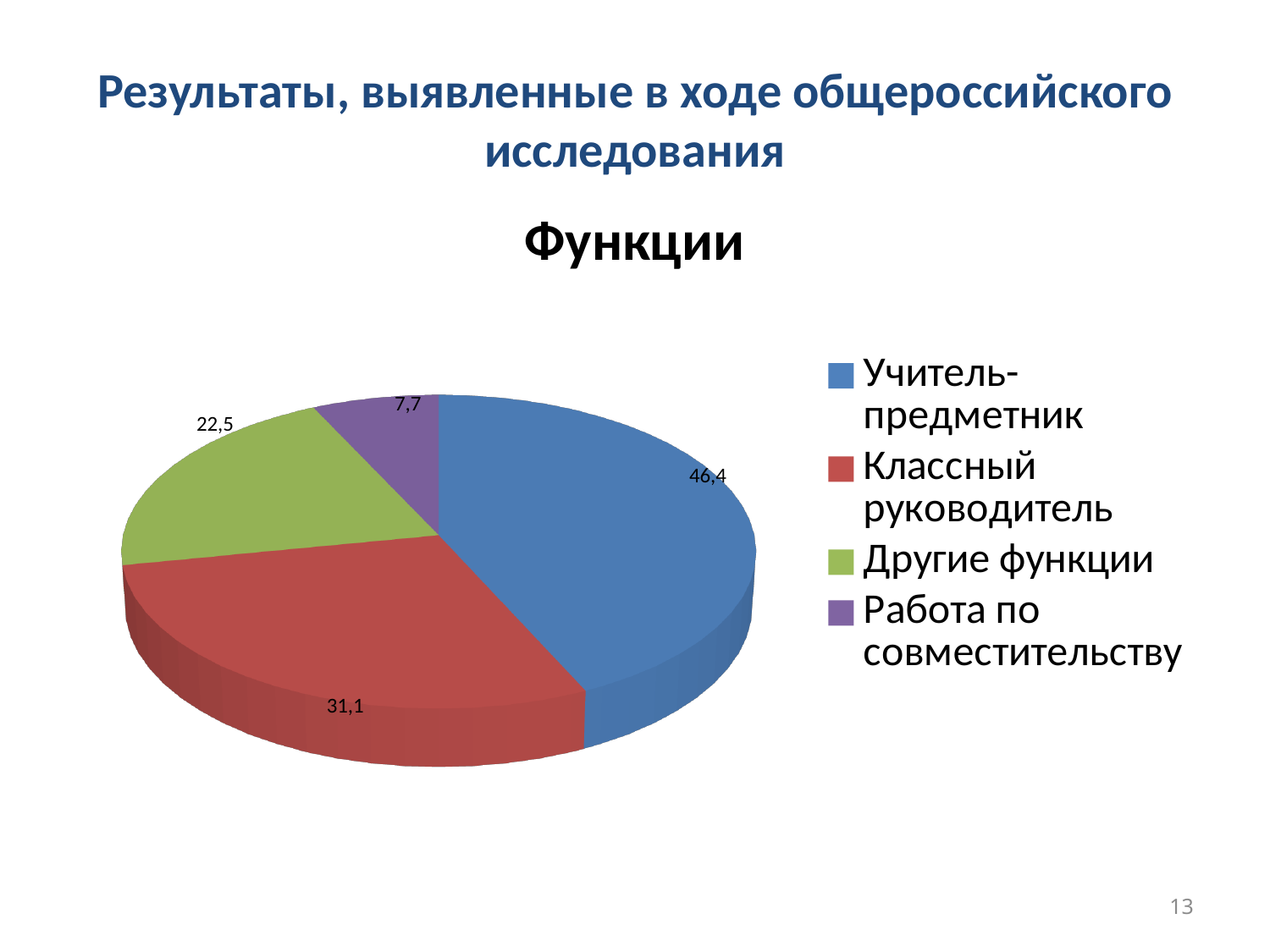
How many categories does the pie chart have? 4 Which category has the smallest slice? Работа по совместительству What is the value for Работа по совместительству? 7,7 What type of chart is shown on the slide? pie chart What is the value for Учитель-предметник? 46,4 Which colour represents Другие функции in the legend? green What is the value for Другие функции? 22,5 What is the value for Классный руководитель? 31,1 What is the title of the chart? Функции Which category has the largest slice? Учитель-предметник What is the difference between the values for Учитель-предметник and Классный руководитель? 15,3 Which is larger, the value for Другие функции or the value for Работа по совместительству? Другие функции